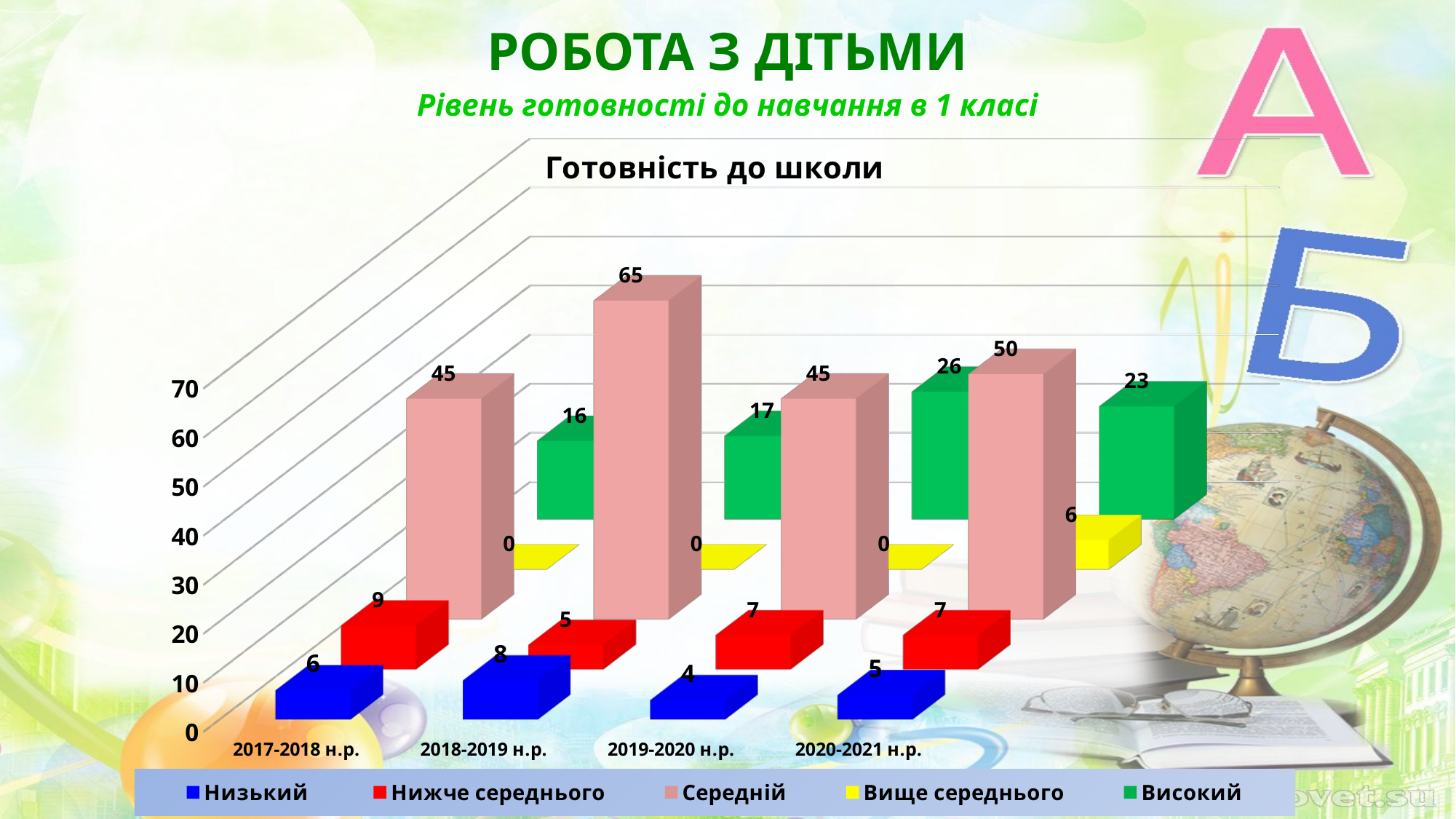
Which is larger: Високий for 2019-2020 н.р. or Високий for 2020-2021 н.р.? 2019-2020 н.р. In which school year is the Середній value highest? 2018-2019 н.р. What is the value of Низький for 2018-2019 н.р.? 8 What is the value of Вище середнього for 2020-2021 н.р.? 6 What is the difference between the Середній values for 2018-2019 н.р. and 2020-2021 н.р.? 15 In which school year is the Низький value lowest? 2019-2020 н.р. What is the value of Середній for 2018-2019 н.р.? 65 How many school years are shown on the x axis? 4 What kind of chart is shown? bar chart How many series does the legend list? 5 What is the title of the chart? Готовність до школи What is the value of Високий for 2019-2020 н.р.? 26